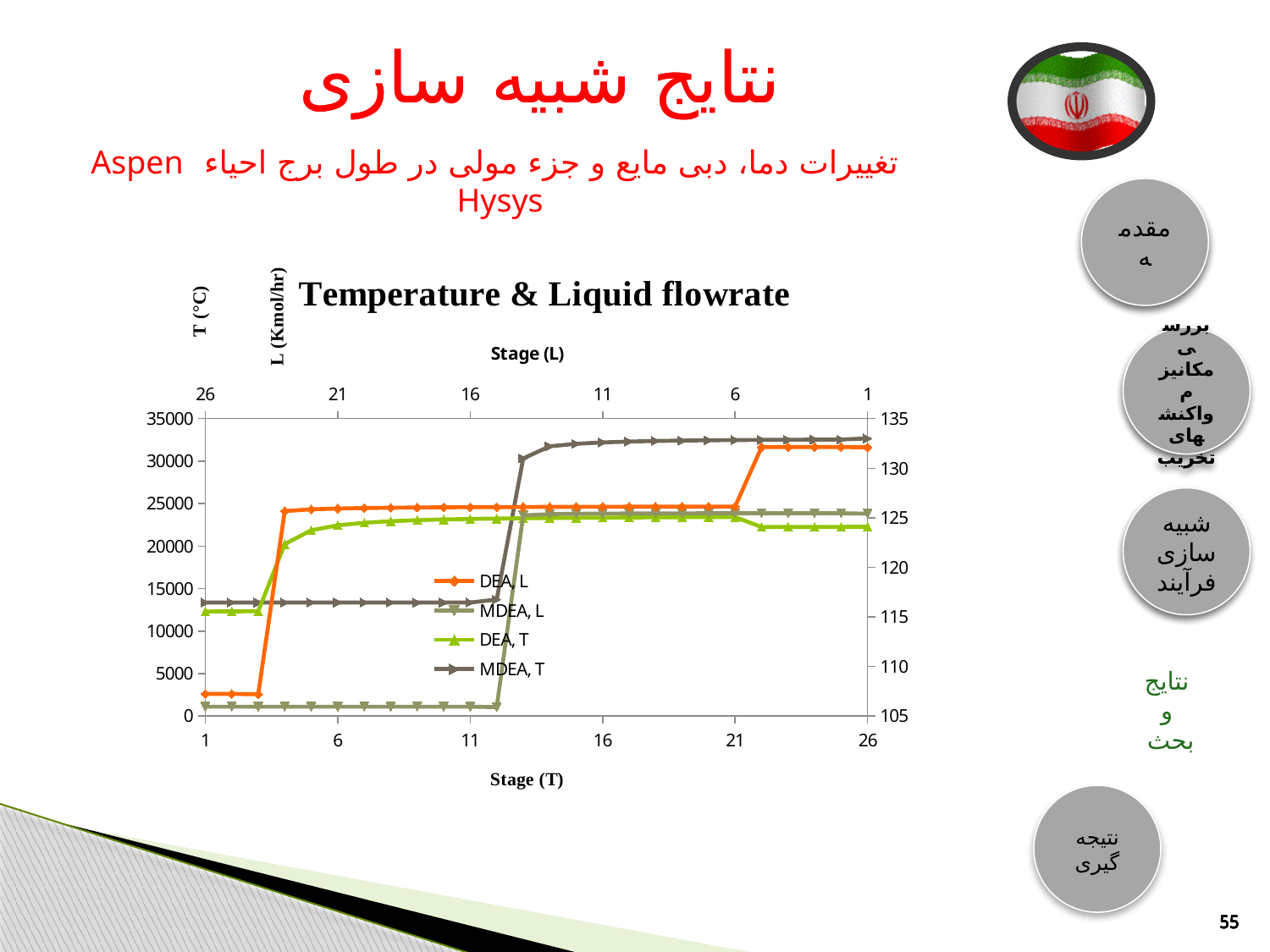
Which series are listed in the chart's legend? DEA, L; MDEA, L; DEA, T; MDEA, T What is the title of the chart? Temperature & Liquid flowrate At stage 26 on the Stage (T) axis, which series has the larger value: DEA, L or MDEA, L? DEA, L What kind of chart is shown on the slide? line chart Is the value of MDEA, L at stage 26 on the Stage (T) axis greater or less than 20000? greater Is the value of DEA, L at stage 1 on the Stage (T) axis greater or less than 5000? less Is the value of MDEA, L at stage 1 on the Stage (T) axis greater or less than 5000? less How many series does the chart's legend list? 4 Does the DEA, L series rise or fall overall from stage 1 to stage 26 along the Stage (T) axis? rise